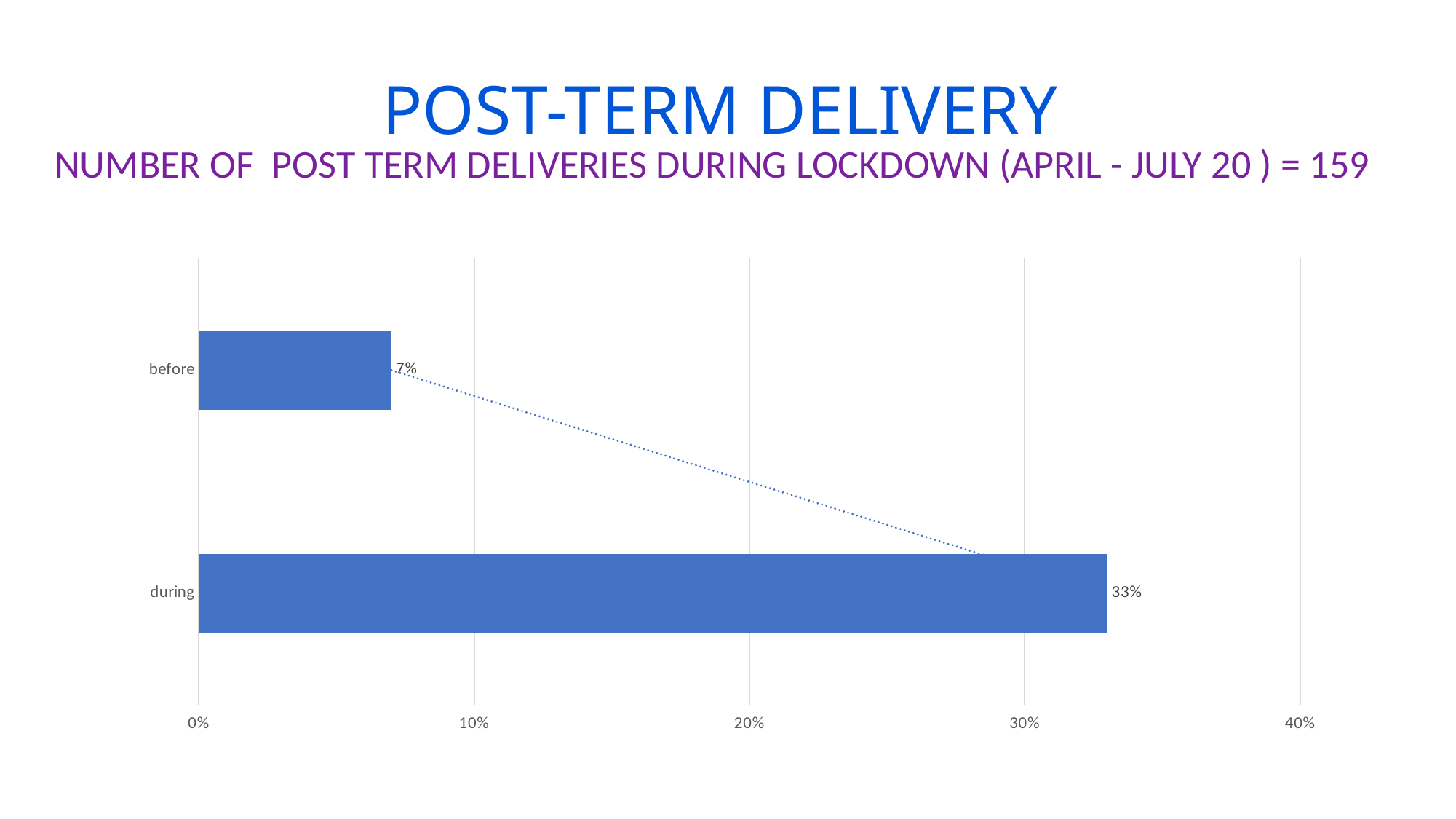
According to the slide subtitle, how many post term deliveries occurred during lockdown (April - July 20)? 159 Which category has the highest value? during What is the difference between the values for "during" and "before"? 26% How many categories are shown in the chart? 2 Is the value for "before" greater or less than 10%? less Which is larger, the value for "before" or the value for "during"? during Is the value for "during" greater or less than 30%? greater What kind of chart is shown on the slide? bar chart Which category has the lowest value? before What is the value for "during"? 33% What is the value for "before"? 7% What is the maximum value shown on the horizontal axis? 40%